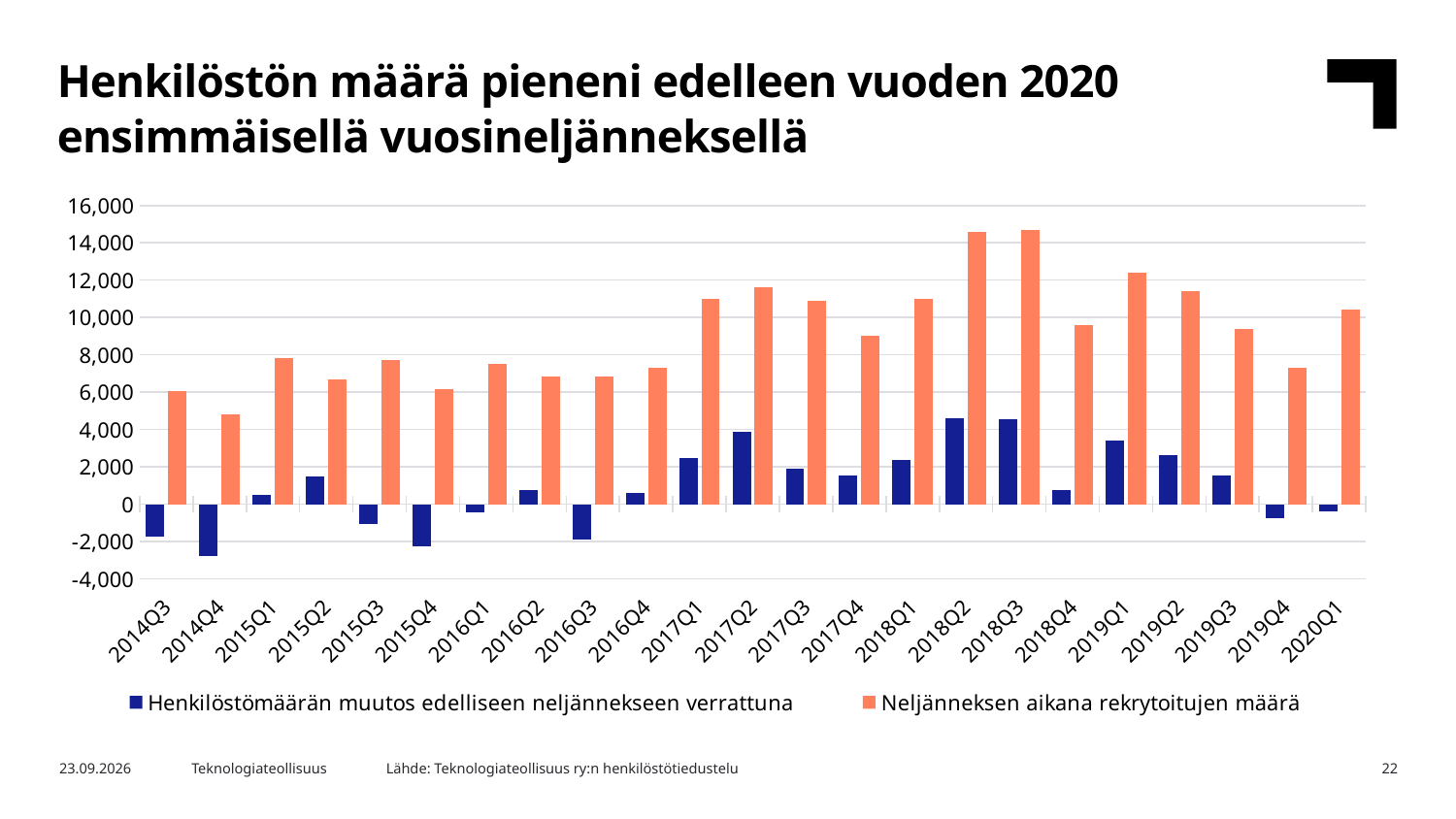
How many quarters are shown on the x axis? 23 Is the value for Neljänneksen aikana rekrytoitujen määrä in 2020Q1 greater or less than 10,000? greater Which is larger for Neljänneksen aikana rekrytoitujen määrä: 2017Q1 or 2016Q4? 2017Q1 Is the value for Henkilöstömäärän muutos edelliseen neljännekseen verrattuna in 2020Q1 greater or less than 0? less Which quarter has the lowest value for Neljänneksen aikana rekrytoitujen määrä? 2014Q4 What kind of chart is shown on the slide? Bar chart What is the first quarter shown on the x axis? 2014Q3 How many series does the legend list? 2 Which is larger for Neljänneksen aikana rekrytoitujen määrä: 2018Q2 or 2014Q4? 2018Q2 Is the value for Neljänneksen aikana rekrytoitujen määrä in 2014Q3 greater or less than 4,000? greater Which series is shown in orange? Neljänneksen aikana rekrytoitujen määrä